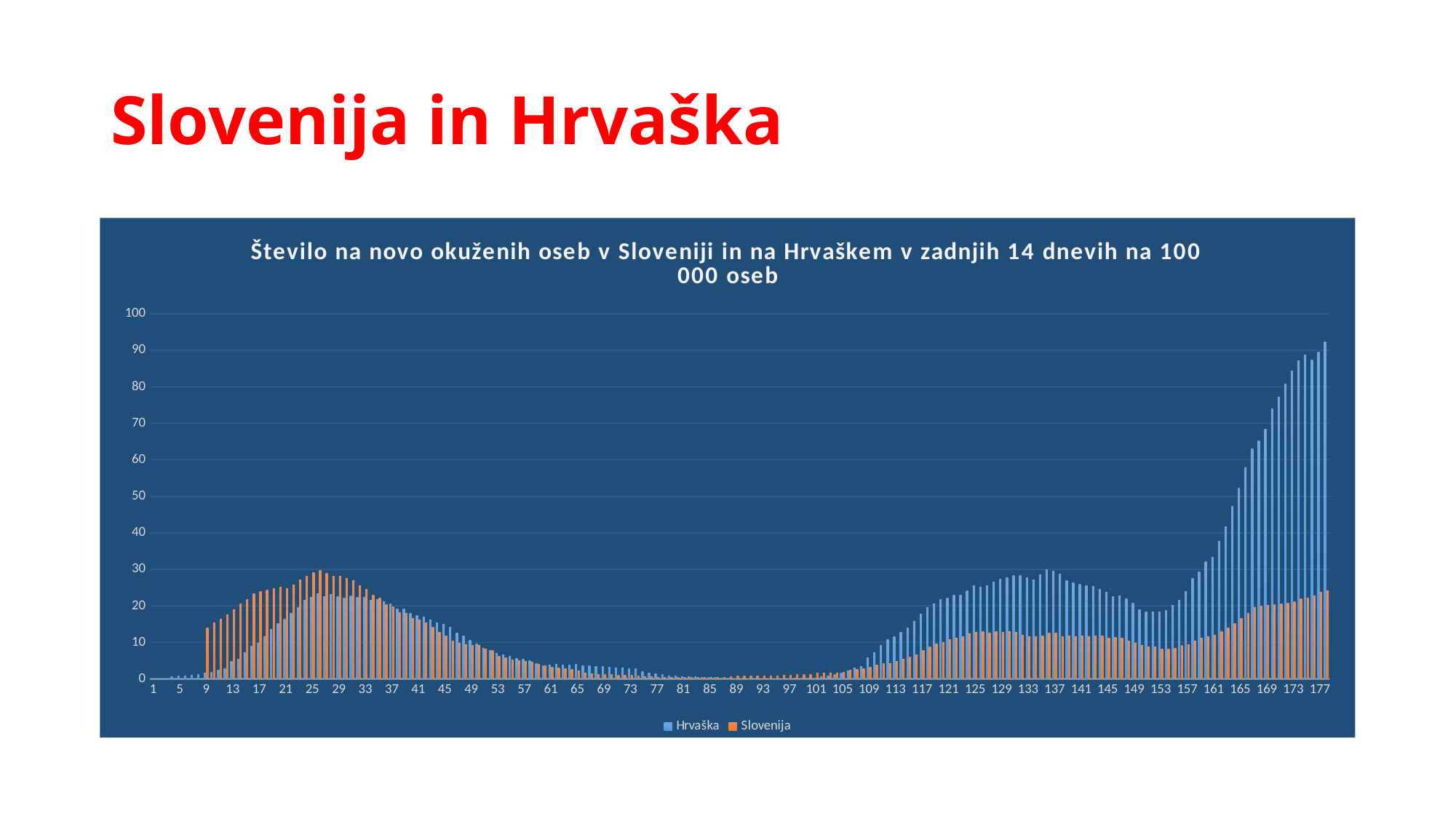
What kind of chart is shown on the slide? bar chart At point 25, which series has the larger value, Hrvaška or Slovenija? Slovenija Do the values for Hrvaška rise or fall from point 161 to point 177? rise Is the value for Hrvaška at point 85 greater or less than 10? less Is the value for Slovenija at point 125 greater or less than 20? less Which series reaches the highest value anywhere on the chart? Hrvaška Is the value for Hrvaška at point 177 greater or less than 80? greater How many series does the chart's legend list? 2 What is the title of the chart? Število na novo okuženih oseb v Sloveniji in na Hrvaškem v zadnjih 14 dnevih na 100 000 oseb At point 177, which series has the larger value, Hrvaška or Slovenija? Hrvaška What are the two series named in the legend? Hrvaška and Slovenija